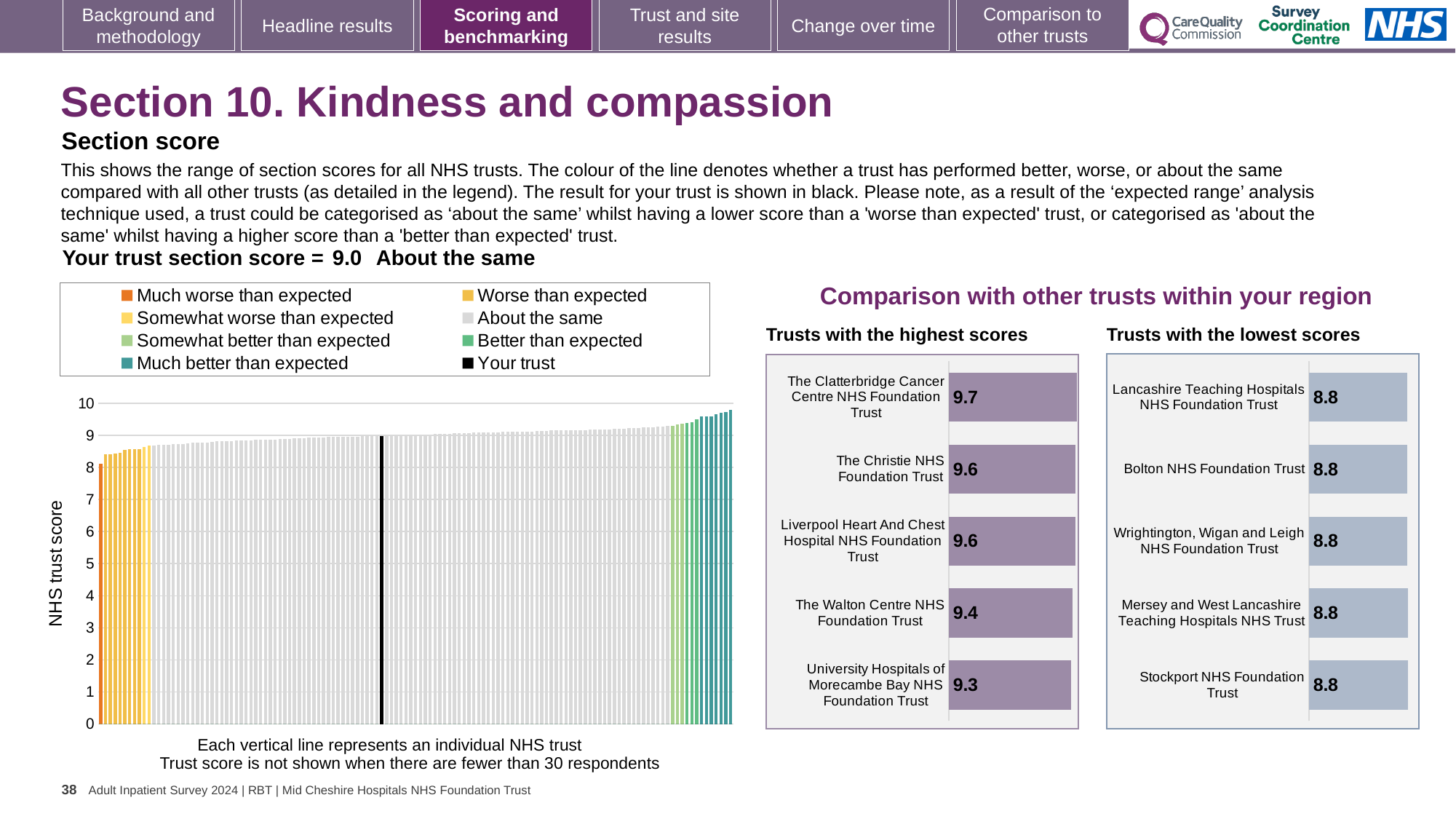
In the 'Trusts with the lowest scores' chart, what is the score for Stockport NHS Foundation Trust? 8.8 In the 'Trusts with the highest scores' chart, which trust has the lowest score? University Hospitals of Morecambe Bay NHS Foundation Trust In the main section score chart on the left, what is the section score for your trust? 9.0 In the 'Trusts with the lowest scores' chart, how many trusts are shown? 5 What kind of chart is the main section score chart on the left? Bar chart In the main section score chart on the left, how many entries does the legend list? 8 In the 'Trusts with the highest scores' chart, what is the difference between the scores of The Clatterbridge Cancer Centre NHS Foundation Trust and University Hospitals of Morecambe Bay NHS Foundation Trust? 0.4 In the 'Trusts with the highest scores' chart, what is the score for The Walton Centre NHS Foundation Trust? 9.4 In the main section score chart on the left, do the trust scores rise or fall from left to right along the x axis? Rise Which is larger: the score for The Christie NHS Foundation Trust in the 'Trusts with the highest scores' chart or the score for Bolton NHS Foundation Trust in the 'Trusts with the lowest scores' chart? The Christie NHS Foundation Trust In the 'Trusts with the highest scores' chart, which trust has the highest score? The Clatterbridge Cancer Centre NHS Foundation Trust In the 'Trusts with the highest scores' chart, what is the score for The Clatterbridge Cancer Centre NHS Foundation Trust? 9.7